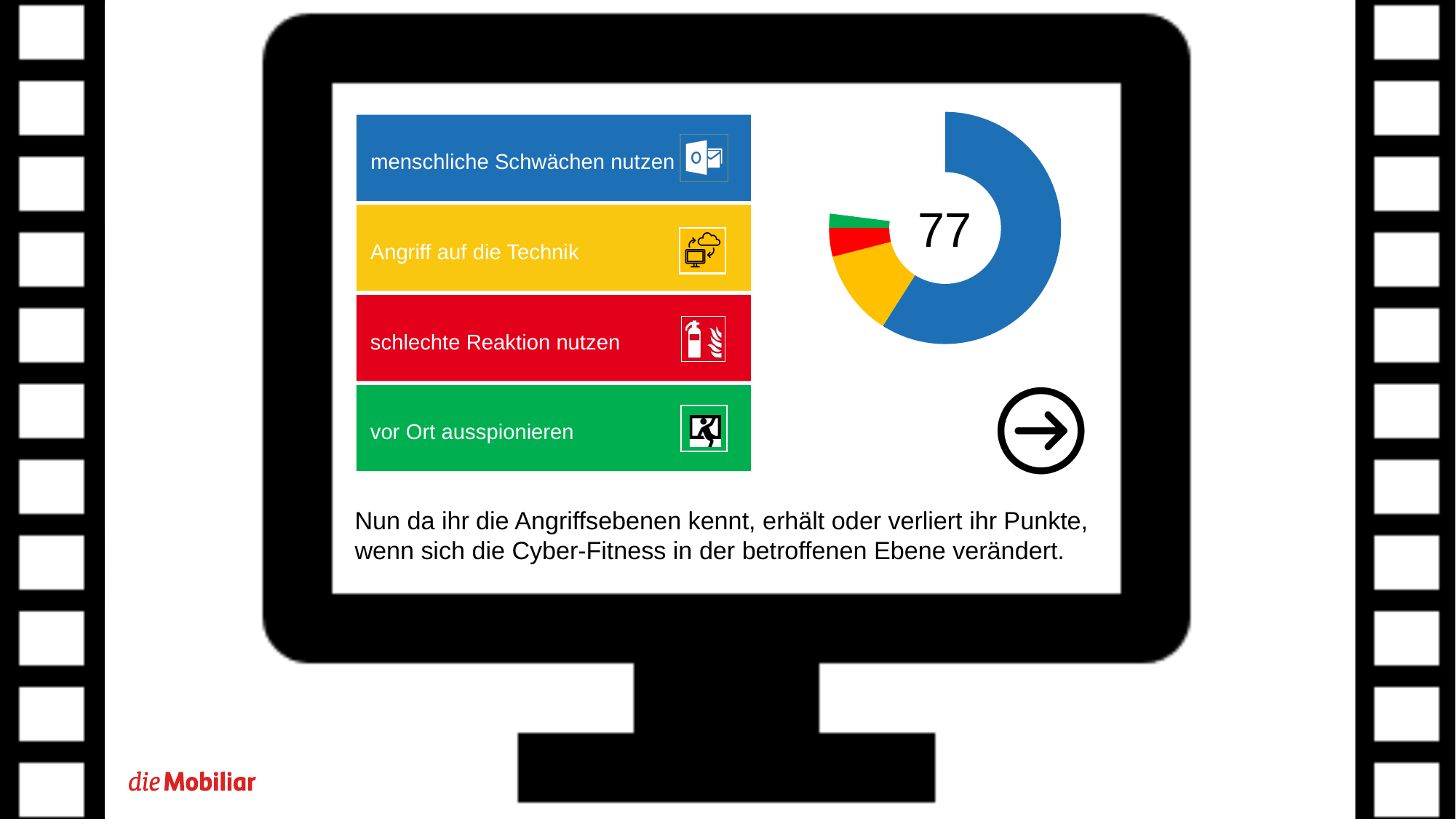
What number is displayed in the centre of the donut chart? 77 What kind of chart is shown on the screen? Donut chart Which segment is larger in the donut chart, the red one or the green one? Red Which category label on the left matches the colour of the largest donut segment? menschliche Schwächen nutzen Which segment is larger in the donut chart, the blue one or the yellow one? Blue Which colour segment is the largest in the donut chart? Blue How many segments does the donut chart have? 4 Which colour segment is the smallest in the donut chart? Green Which segment is larger in the donut chart, the yellow one or the red one? Yellow